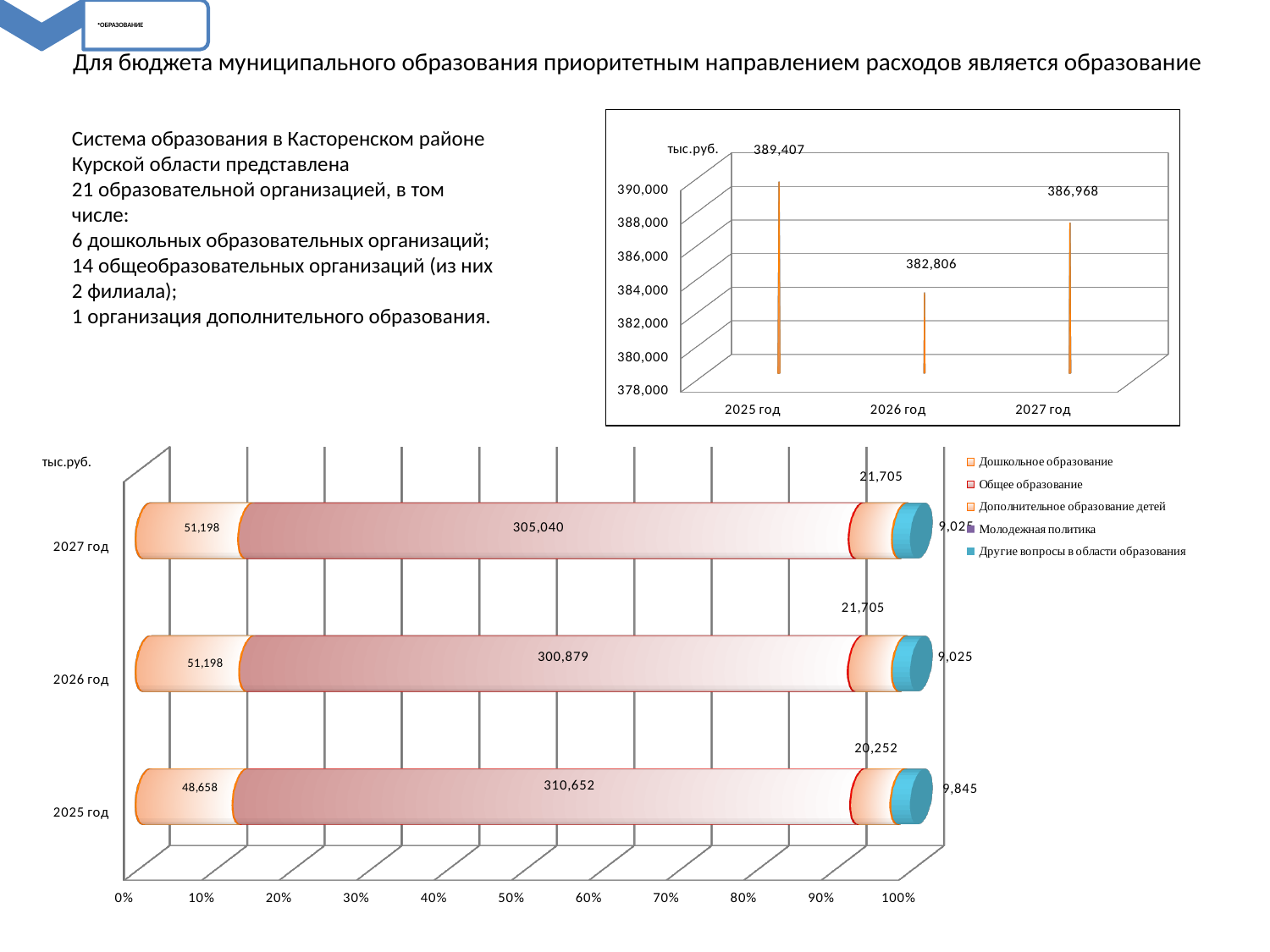
In the bottom chart, what is the value for Общее образование in 2025 год? 310,652 In the top-right chart, which year has the highest value? 2025 год In the top-right chart, what is the value for 2025 год? 389,407 In the top-right chart, what is the value for 2026 год? 382,806 In the bottom chart, which is larger: Общее образование in 2026 год or in 2027 год? 2027 год In the bottom chart, what is the value for Дошкольное образование in 2027 год? 51,198 What kind of chart is the bottom chart? Stacked bar chart In the top-right chart, how many years are plotted? 3 In the bottom chart, what is the value for Дополнительное образование детей in 2025 год? 20,252 In the top-right chart, which year has the lowest value? 2026 год In the top-right chart, what is the difference between the values for 2025 год and 2027 год? 2,439 In the bottom chart, how many series does the legend list? 5